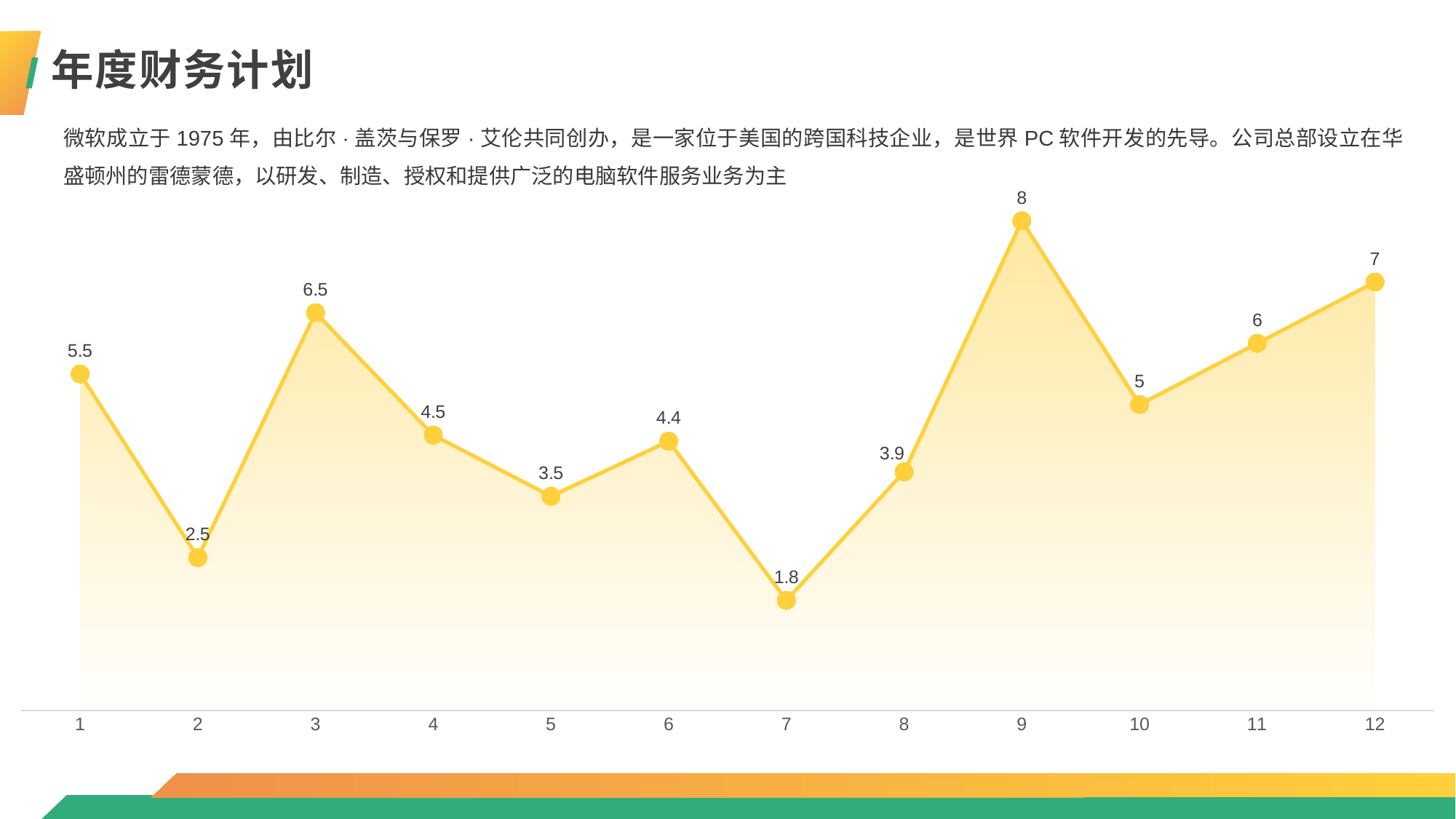
What is the value at x = 9? 8 At which x value is the plotted value lowest? 7 Which has the larger value, x = 4 or x = 6? 4 What kind of chart is shown on the slide? Area chart What is the value at x = 12? 7 Do the values rise or fall from x = 9 to x = 10? Fall What is the value at x = 3? 6.5 At which x value is the plotted value highest? 9 What is the value at x = 7? 1.8 What is the difference between the values at x = 9 and x = 7? 6.2 How many data points are plotted on the chart? 12 What is the difference between the values at x = 1 and x = 2? 3